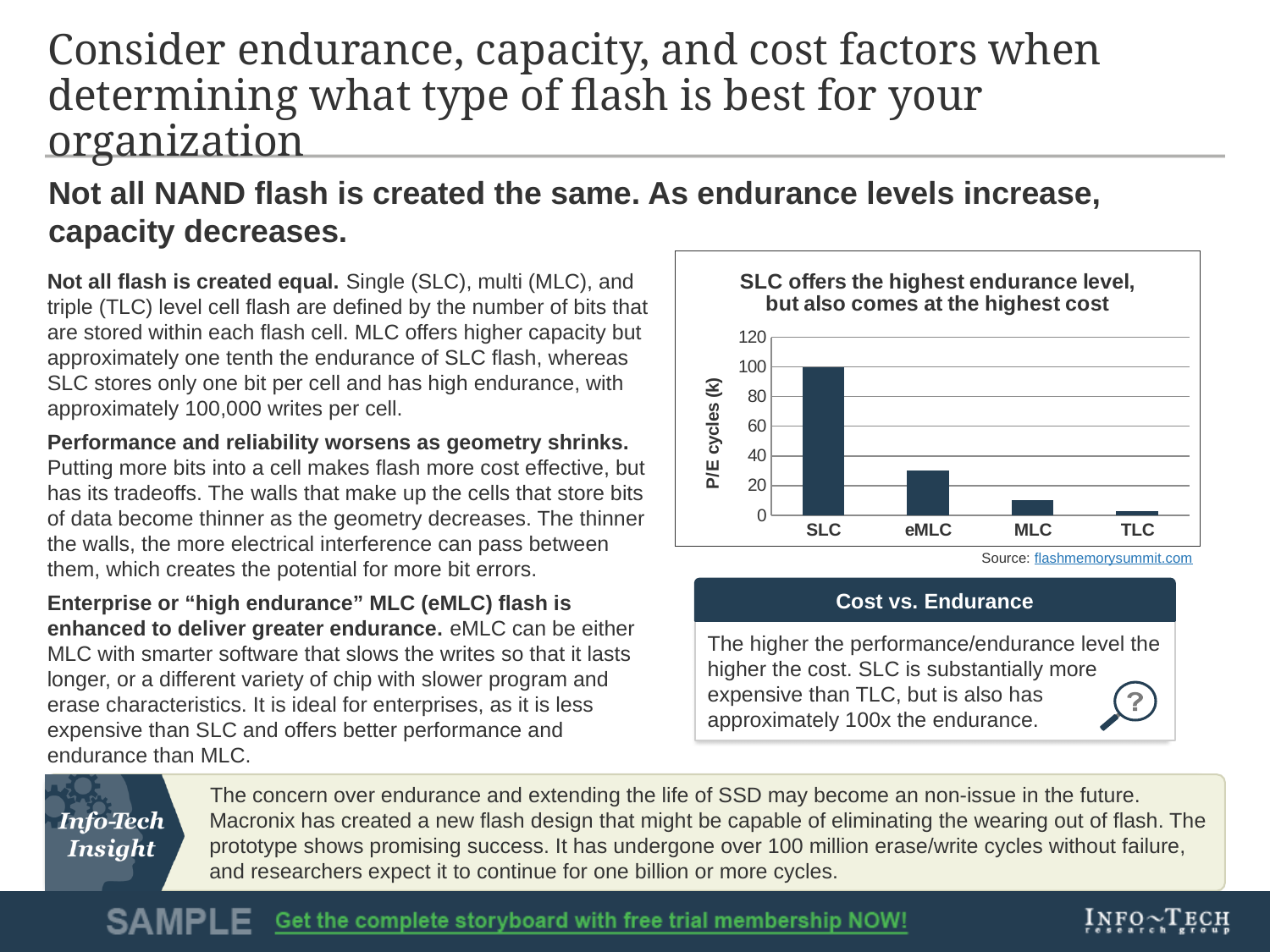
Is the value for eMLC greater or less than 20? greater How many categories are shown on the x axis of the chart? 4 Which category has the highest value in the chart? SLC What is the label on the y axis of the chart? P/E cycles (k) Which has a larger value, eMLC or MLC? eMLC Is the value for eMLC greater or less than 40? less What is the value for SLC in the chart? 100 What is the title of the chart? SLC offers the highest endurance level, but also comes at the highest cost Do the values rise or fall moving from SLC to TLC along the x axis? fall Is the value for MLC greater or less than 20? less What type of chart is shown on the slide? bar chart Which category has the lowest value in the chart? TLC